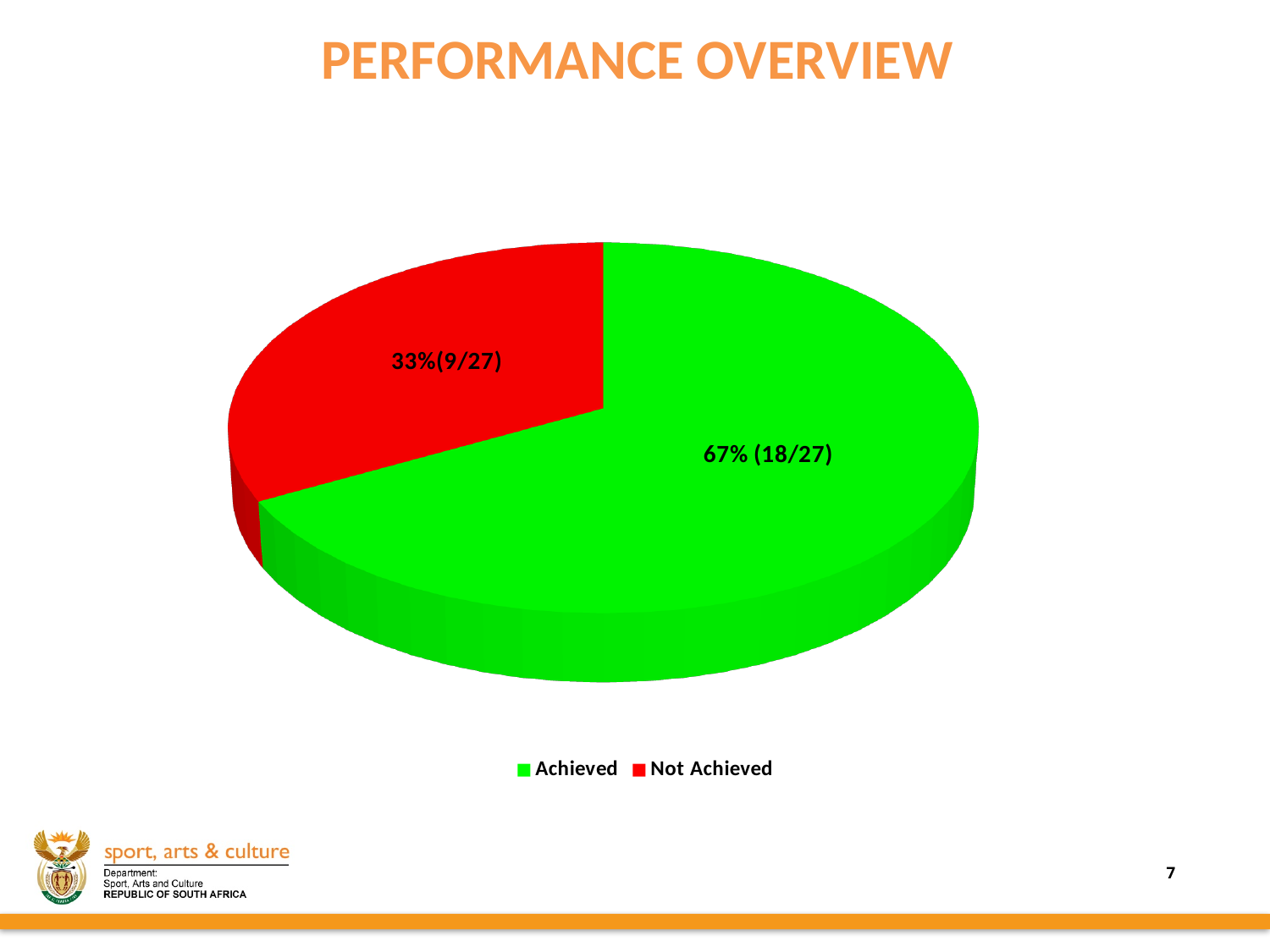
What share of the pie does the Not Achieved slice represent? 33% What kind of chart is shown on the slide? pie chart What is the data label shown on the Not Achieved slice? 33%(9/27) Which is larger, the Achieved slice or the Not Achieved slice? Achieved What is the difference in percentage points between the Achieved and Not Achieved slices? 34 Which slice is the smallest? Not Achieved What colour is the Not Achieved slice? red What share of the pie does the Achieved slice represent? 67% Which slice is the largest? Achieved How many slices does the pie chart have? 2 How many targets were achieved, according to the data label? 18 What is the data label shown on the Achieved slice? 67% (18/27)